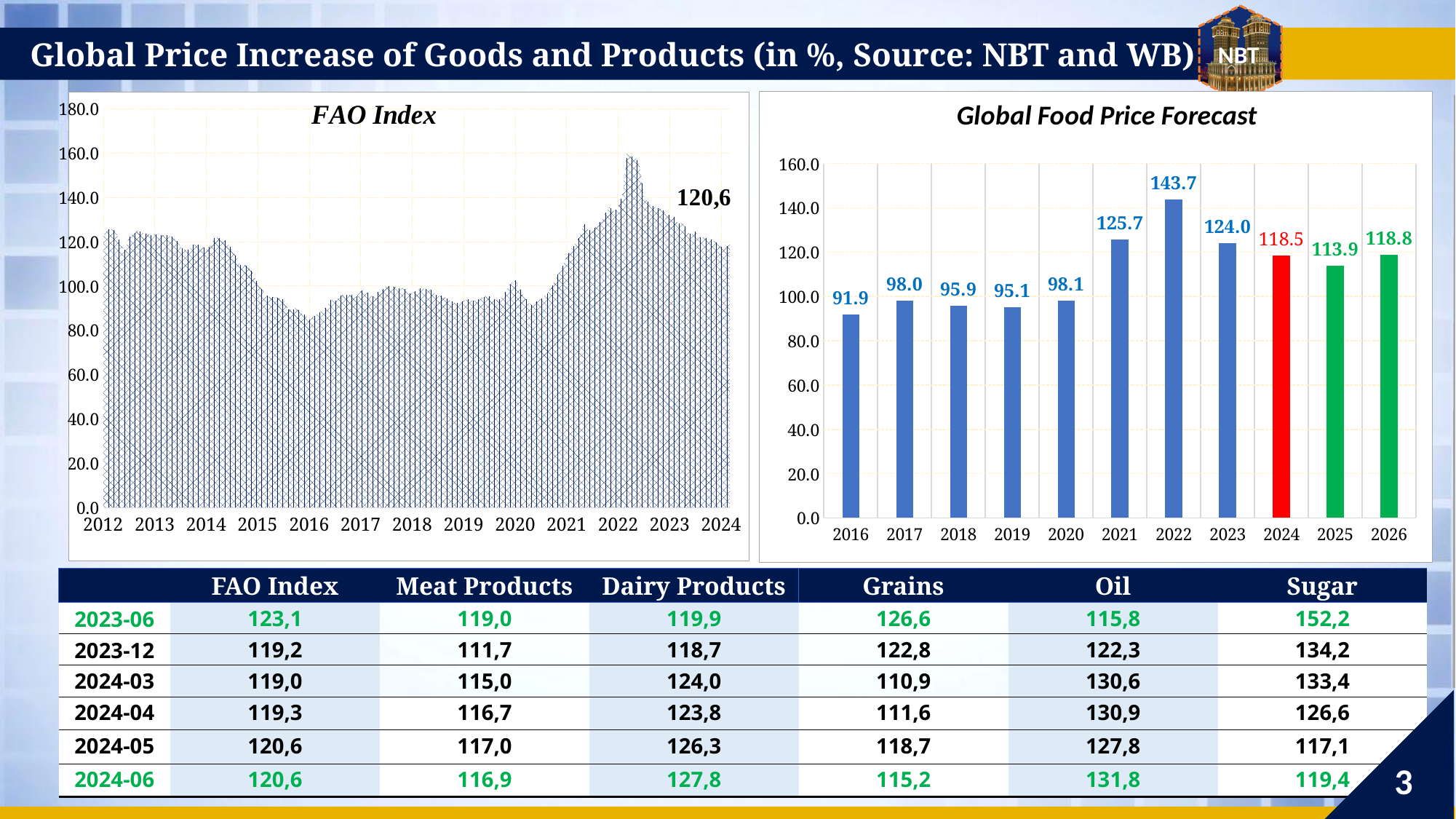
In the Global Food Price Forecast chart, which is larger, the value for 2021 or the value for 2024? 2021 In the Global Food Price Forecast chart, what is the difference between the values for 2022 and 2023? 19.7 In the Global Food Price Forecast chart, which year has the highest value? 2022 In the Global Food Price Forecast chart, what is the value for 2022? 143.7 How many years are shown on the x axis of the Global Food Price Forecast chart? 11 In the FAO Index chart, is the value around 2016 greater or less than 100? less In the FAO Index chart, what is the value labelled at the end of the series in 2024? 120,6 In the Global Food Price Forecast chart, what is the value for 2016? 91.9 In the Global Food Price Forecast chart, what is the value for 2025? 113.9 What kind of chart is the Global Food Price Forecast chart? bar chart In the Global Food Price Forecast chart, which year has the lowest value? 2016 In the FAO Index chart, is the value at the 2022 peak greater or less than 140? greater